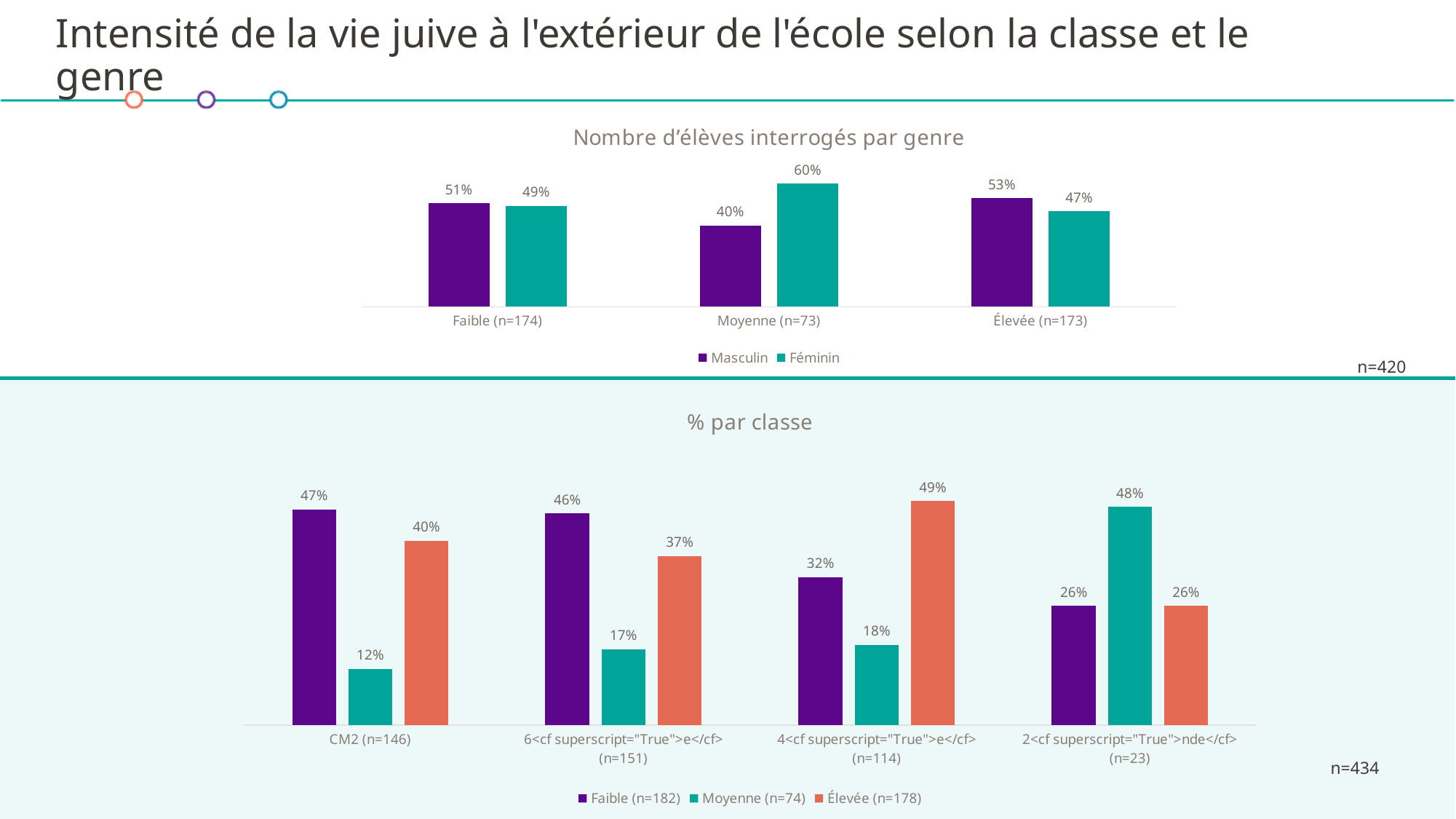
In the chart titled "% par classe", which category has the lowest Moyenne (n=74) value? CM2 (n=146) What kind of chart is the chart titled "% par classe"? Bar chart In the chart titled "Nombre d'élèves interrogés par genre", what is the Masculin value for Élevée (n=173)? 53% In the chart titled "Nombre d'élèves interrogés par genre", which category has the highest Féminin value? Moyenne (n=73) In the chart titled "Nombre d'élèves interrogés par genre", what is the Féminin value for Moyenne (n=73)? 60% In the chart titled "% par classe", what is the difference between the Faible (n=182) and Moyenne (n=74) values for CM2 (n=146)? 35% In the chart titled "Nombre d'élèves interrogés par genre", what is the difference between the Féminin and Masculin values for Moyenne (n=73)? 20% In the chart titled "Nombre d'élèves interrogés par genre", how many series does the legend list? 2 In the chart titled "% par classe", what is the Moyenne (n=74) value for CM2 (n=146)? 12% In the chart titled "% par classe", what is the Élevée (n=178) value for the fourth category (n=23)? 26% In the chart titled "% par classe", which category has the highest Élevée (n=178) value? 4e (n=114) In the chart titled "% par classe", how many categories are shown on the x axis? 4